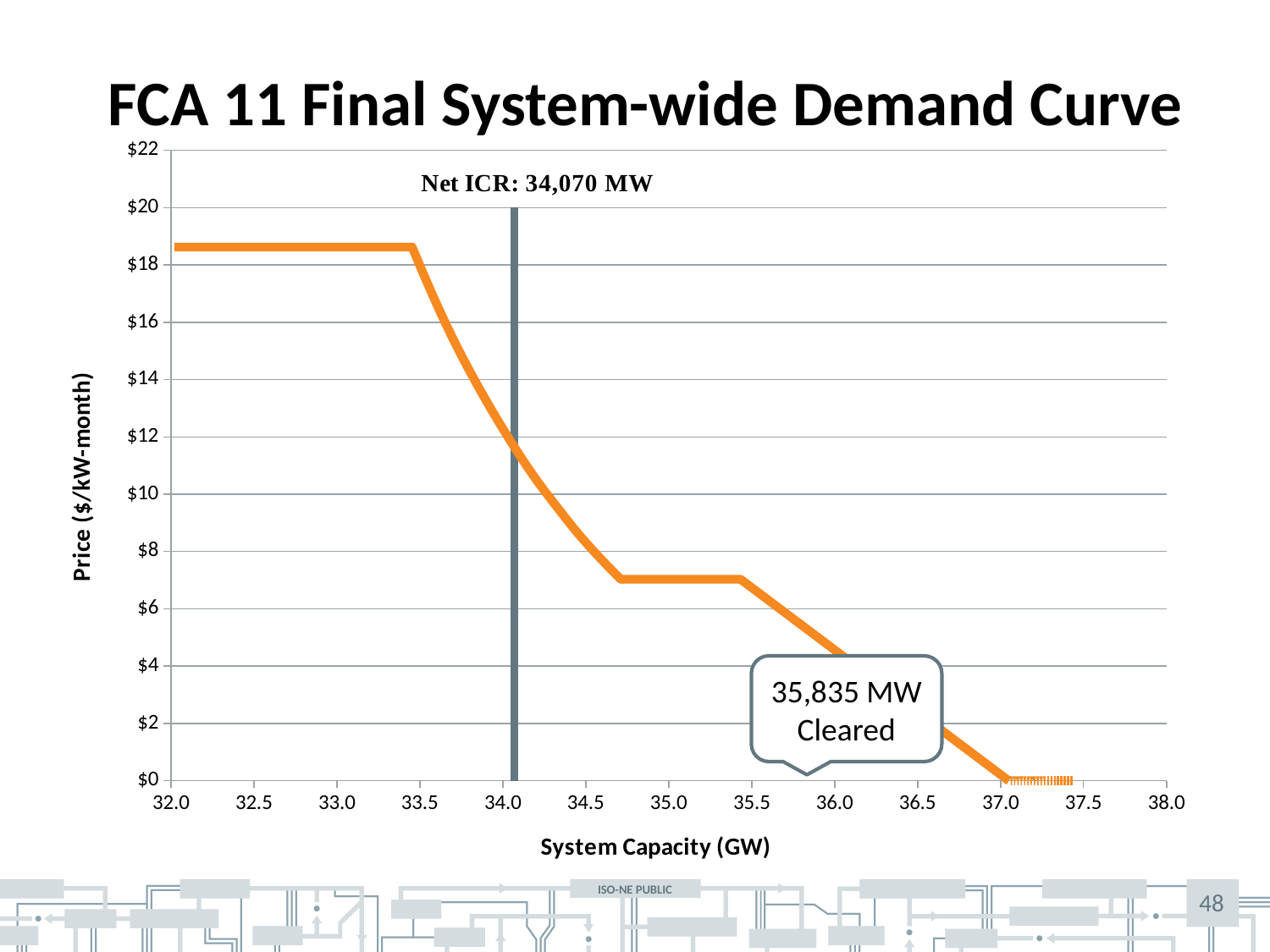
Is the price at a system capacity of 33.0 GW greater or less than $16? greater Is the price at a system capacity of 34.5 GW greater or less than $12? less Is the price at a system capacity of 35.0 GW greater or less than $8? less What is the title of the chart? FCA 11 Final System-wide Demand Curve Which is higher, the price at 33.0 GW or the price at 35.0 GW? 33.0 GW What is the label of the x axis? System Capacity (GW) How many MW does the callout say cleared? 35,835 MW What Net ICR value is annotated on the chart? 34,070 MW Does the price rise or fall as system capacity increases along the x axis? fall What kind of chart is shown on the slide? line chart What is the highest value shown on the y axis? $22